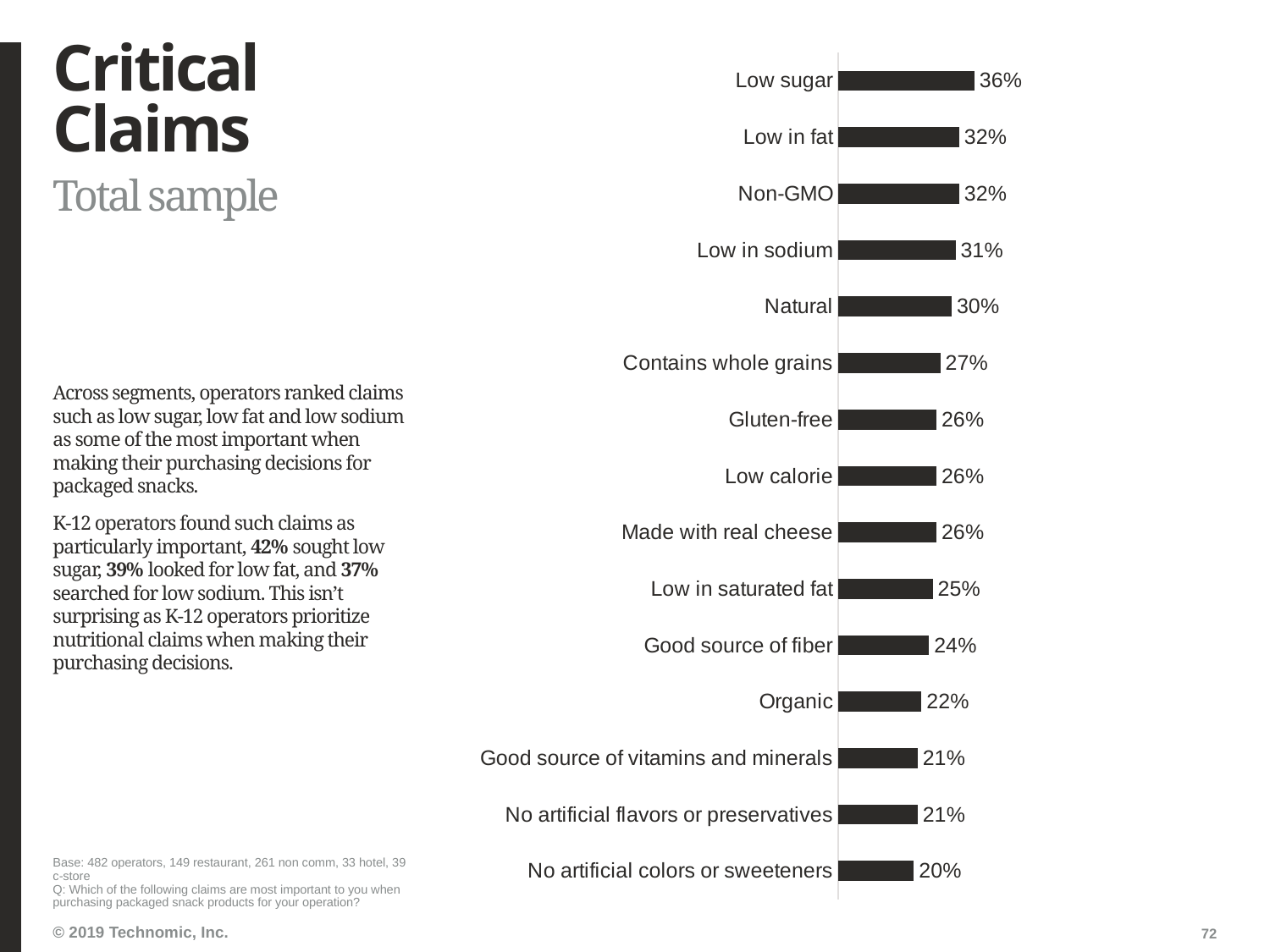
What type of chart is shown on the slide? Bar chart Do the values rise or fall moving from the top bar to the bottom bar? Fall Which claim has the lowest percentage in the chart? No artificial colors or sweeteners What is the difference between the values for Contains whole grains and Organic? 5% Which claim has the highest percentage in the chart? Low sugar What is the value shown for Good source of fiber? 24% What is the difference between the values for Low sugar and Low in fat? 4% Which has a higher value, Low in sodium or Gluten-free? Low in sodium What percentage of operators selected Low sugar as a critical claim? 36% What is the value shown for Natural? 30% Which has a higher value, Low in saturated fat or Good source of vitamins and minerals? Low in saturated fat How many claims are plotted in the chart? 15